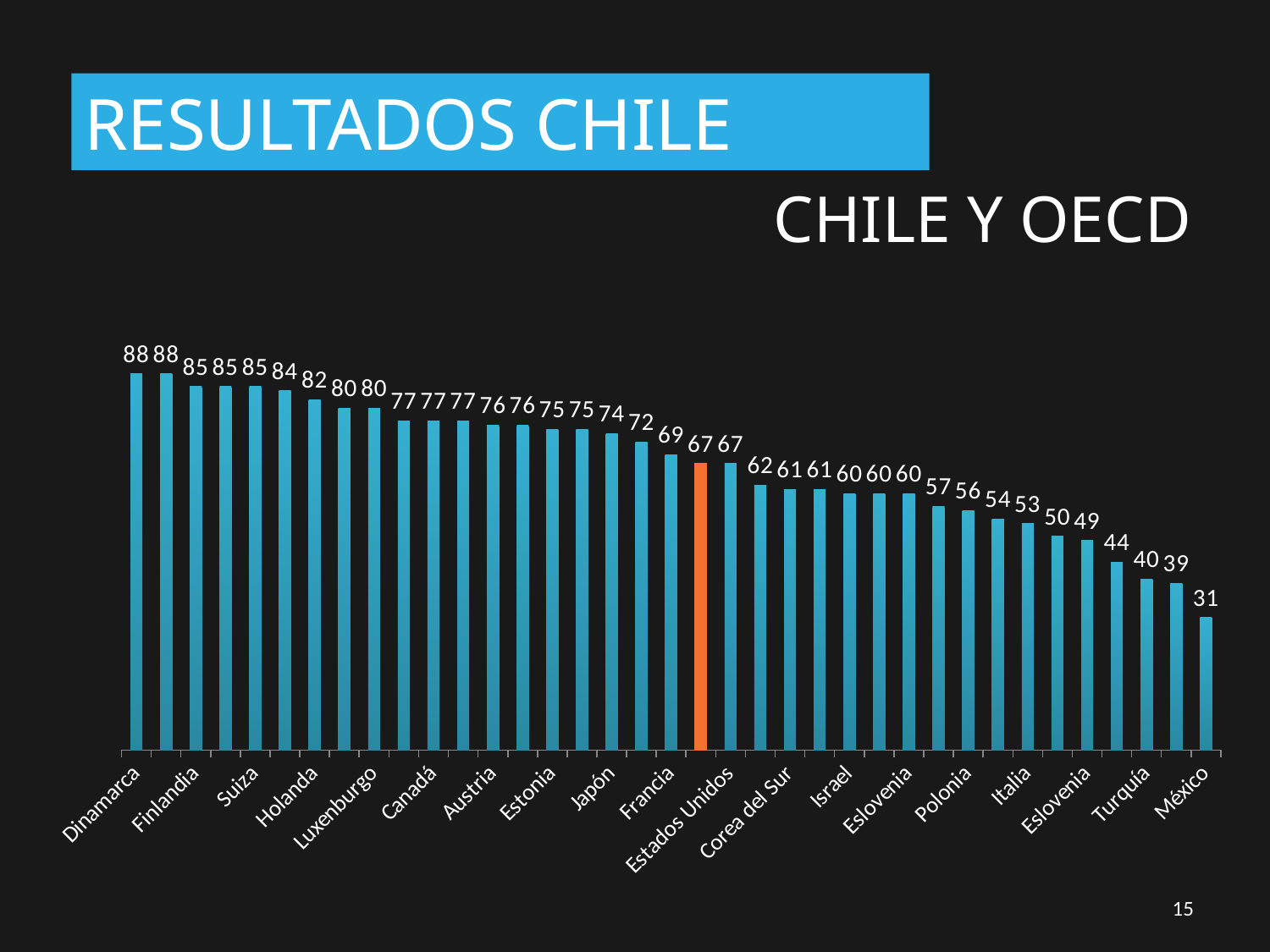
What is the value for México? 31 What kind of chart is shown on the slide? bar chart What is the value for Japón? 74 How many bars are plotted in the chart? 37 What is the value for Estados Unidos? 67 Which has a larger value, Canadá or Italia? Canadá What is the difference between the values for Dinamarca and México? 57 Which labeled country has the lowest value? México Do the values rise or fall from left to right along the x axis? fall What is the value for Dinamarca? 88 What value is labeled on the orange highlighted bar? 67 What is the value for Turquía? 40